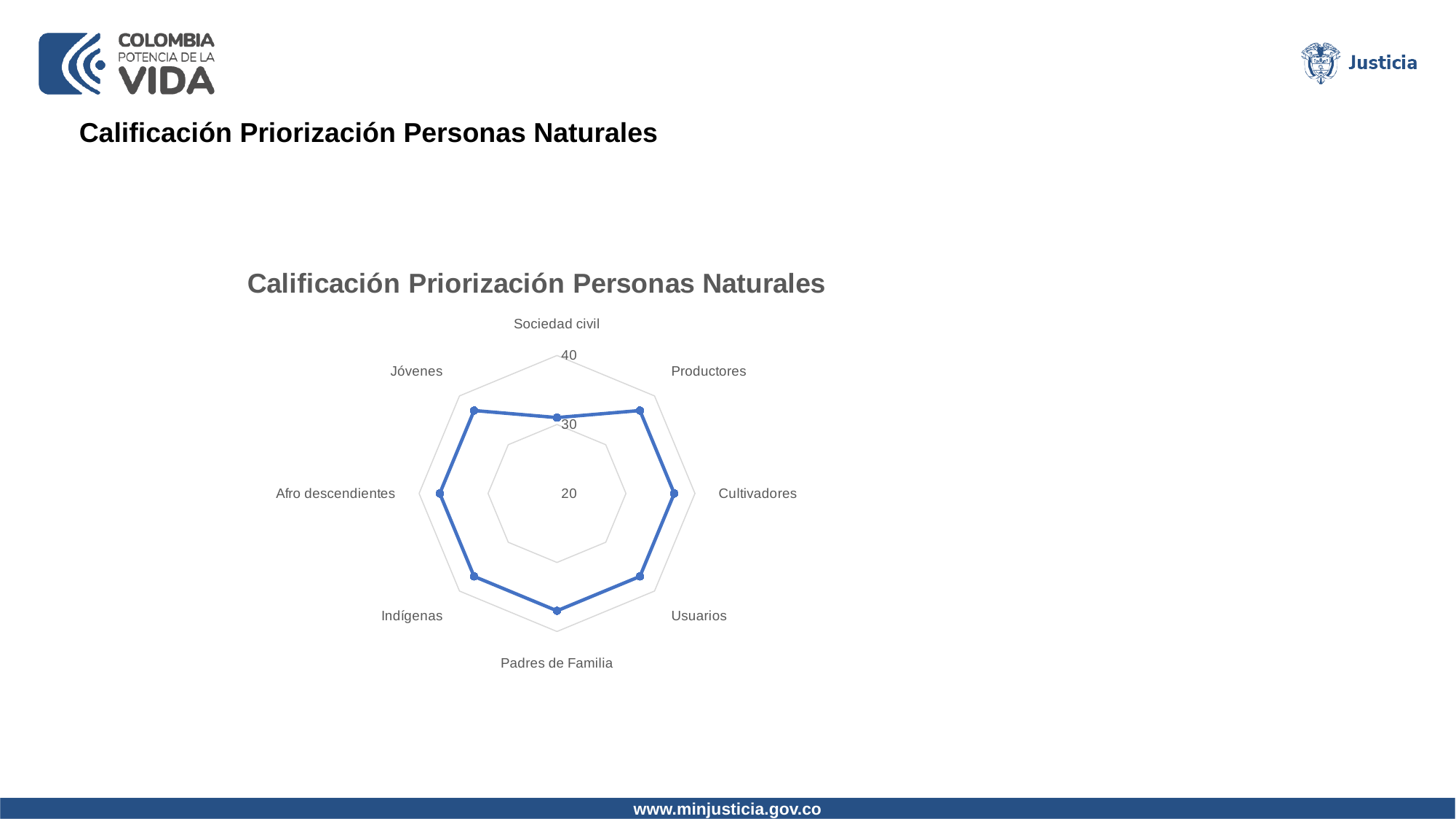
Is the value for Padres de Familia greater or less than 30? greater What is the title of the chart? Calificación Priorización Personas Naturales How many categories are plotted on the radar chart? 8 Is the value for Indígenas greater or less than 40? less Is the value for Cultivadores greater or less than 30? greater What is the highest value shown on the chart's axis scale? 40 Which category has the lowest value on the chart? Sociedad civil Which is larger, the value for Productores or the value for Sociedad civil? Productores What kind of chart is shown on the slide? radar chart